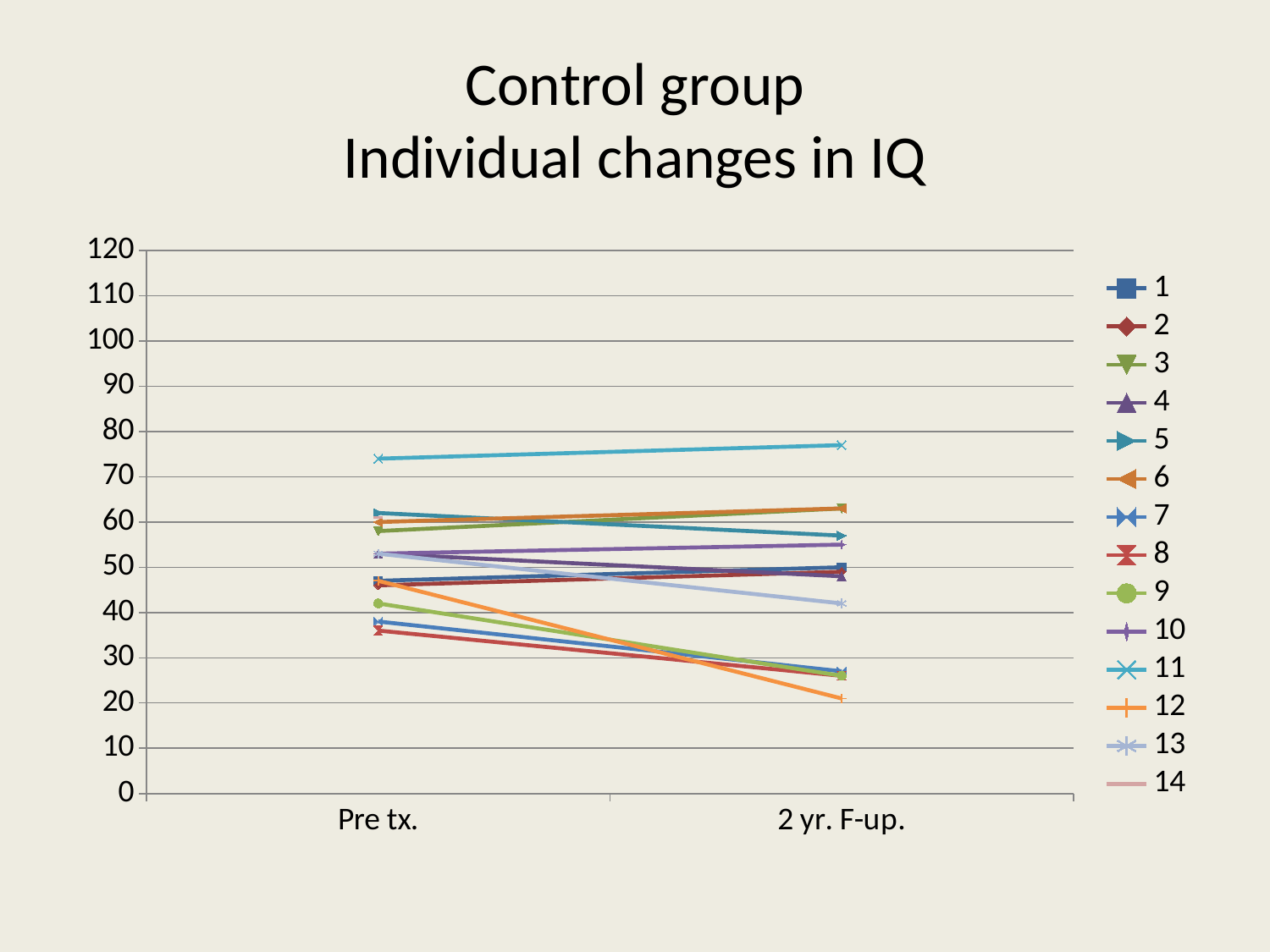
Is the value for series 12 at 2 yr. F-up. greater or less than 30? less Is the value for series 13 at 2 yr. F-up. greater or less than 50? less What kind of chart is shown on the slide? line chart How many series does the legend list? 14 What are the two x-axis category labels? Pre tx. and 2 yr. F-up. What is the title of the chart? Control group Individual changes in IQ Which series has the lowest value at 2 yr. F-up.? 12 Does series 12 rise or fall from Pre tx. to 2 yr. F-up.? fall Is the value for series 11 at Pre tx. greater or less than 70? greater Which series has the highest value at Pre tx.? 11 Which series has the highest value at 2 yr. F-up.? 11 How many categories are on the x axis? 2